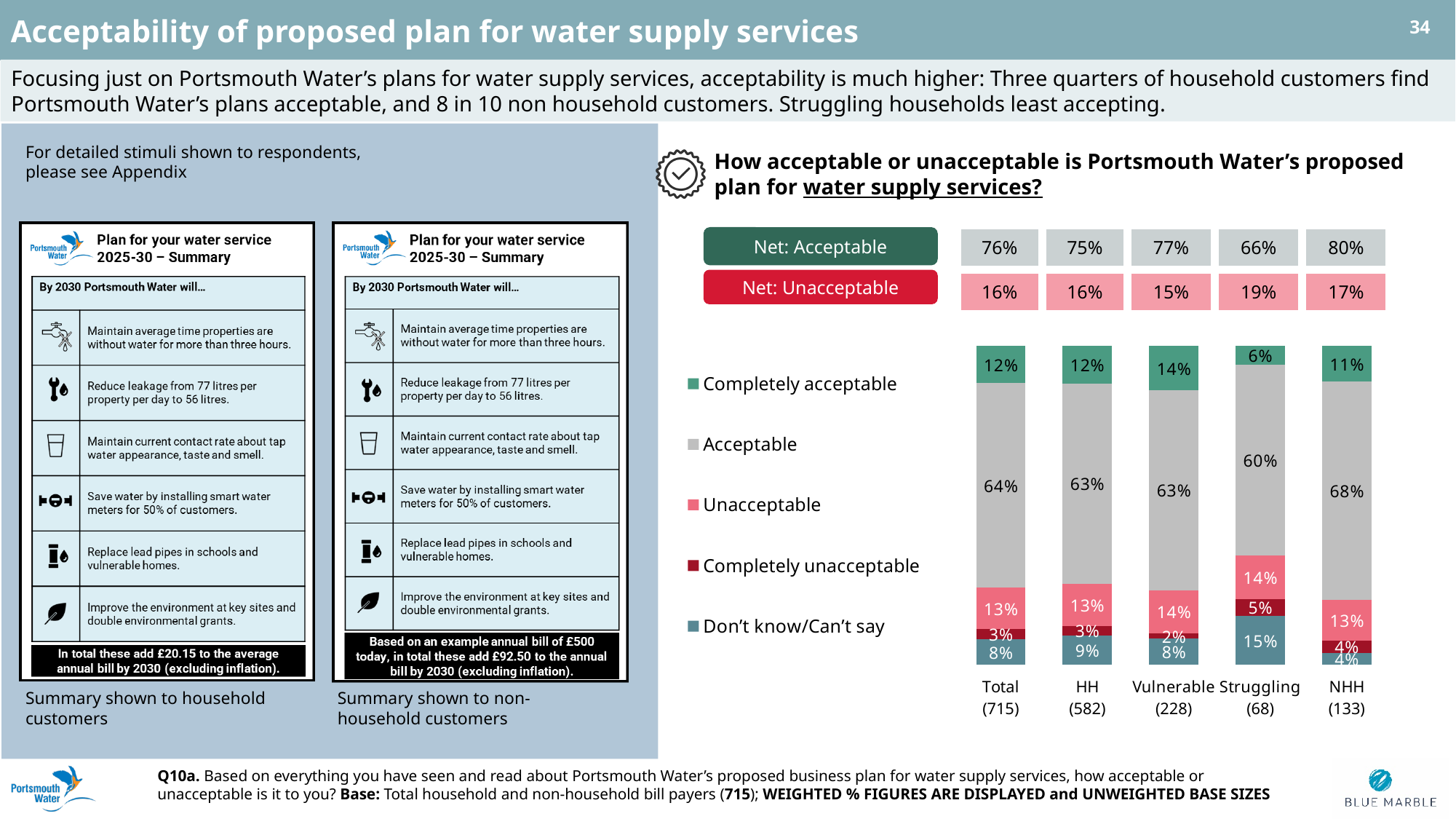
What percentage of NHH customers answered Don't know/Can't say? 4% Which group has the highest Acceptable percentage? NHH What kind of chart is used to show the acceptability responses? Stacked bar chart How many groups are shown along the x axis of the stacked bar chart? 5 What is the Net: Acceptable figure for the Struggling group? 66% How many series does the legend of the stacked bar chart list? 5 What is the Completely acceptable value for the Vulnerable group? 14% What is the difference between the Don't know/Can't say values for Struggling and Total? 7% What percentage of Struggling customers said the plan is Acceptable? 60% Which group has the highest Net: Unacceptable figure? Struggling Which group has the lowest Completely acceptable percentage? Struggling Is the Completely unacceptable value larger for Struggling or for HH? Struggling